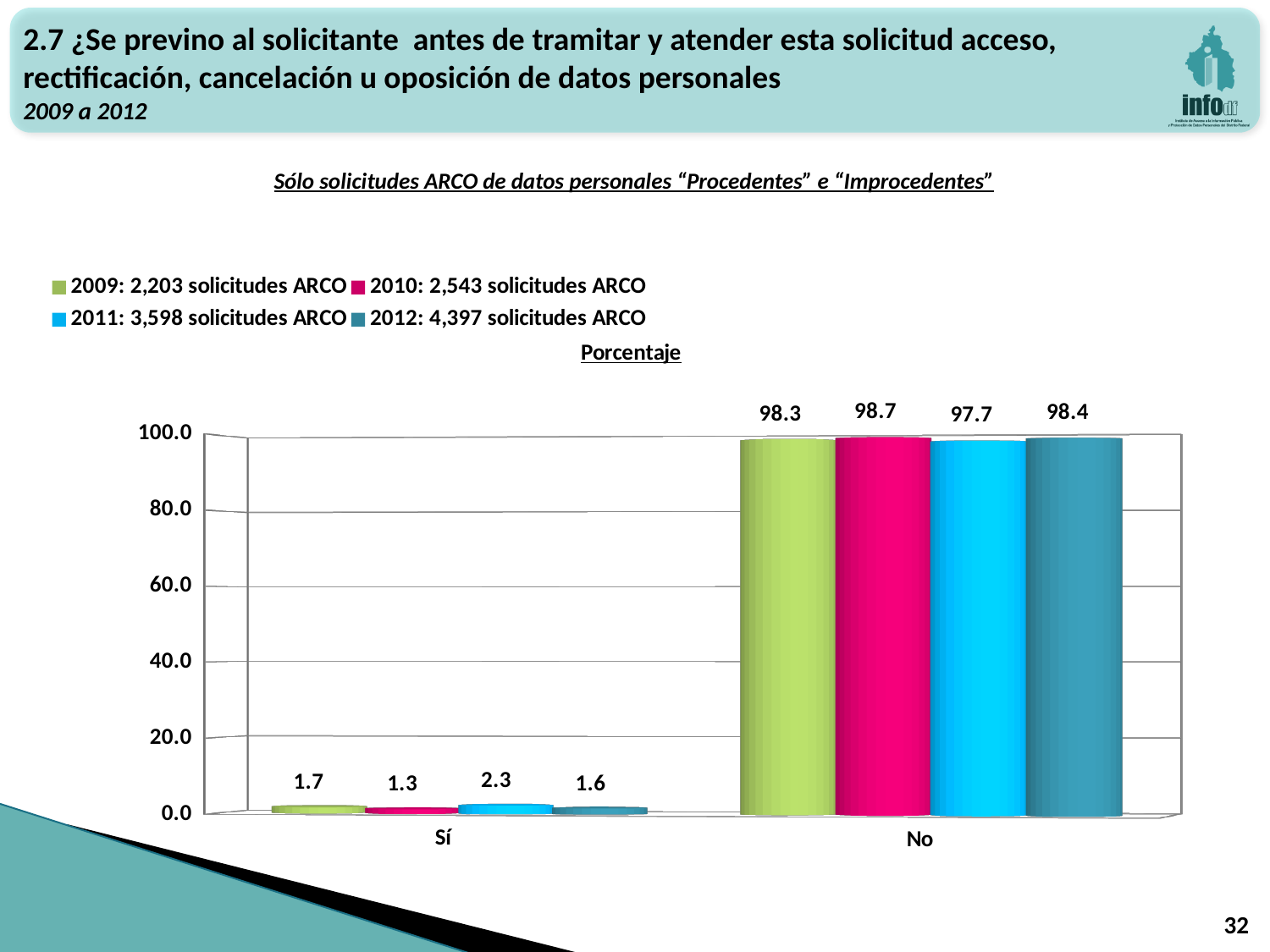
What is the value for 2011 in the "No" category? 97.7 How many series does the legend list? 4 According to the legend, how many solicitudes ARCO were there in 2012? 4,397 How many categories are shown on the x axis? 2 What is the value for 2010 in the "No" category? 98.7 Which year has the lowest value in the "Sí" category? 2010 Which is larger: the 2010 value for "No" or the 2011 value for "No"? 2010 What is the difference between the 2011 and 2010 values in the "Sí" category? 1.0 What is the value for 2009 in the "Sí" category? 1.7 What kind of chart is shown on the slide? Bar chart What is the value for 2012 in the "Sí" category? 1.6 Which year has the highest value in the "Sí" category? 2011